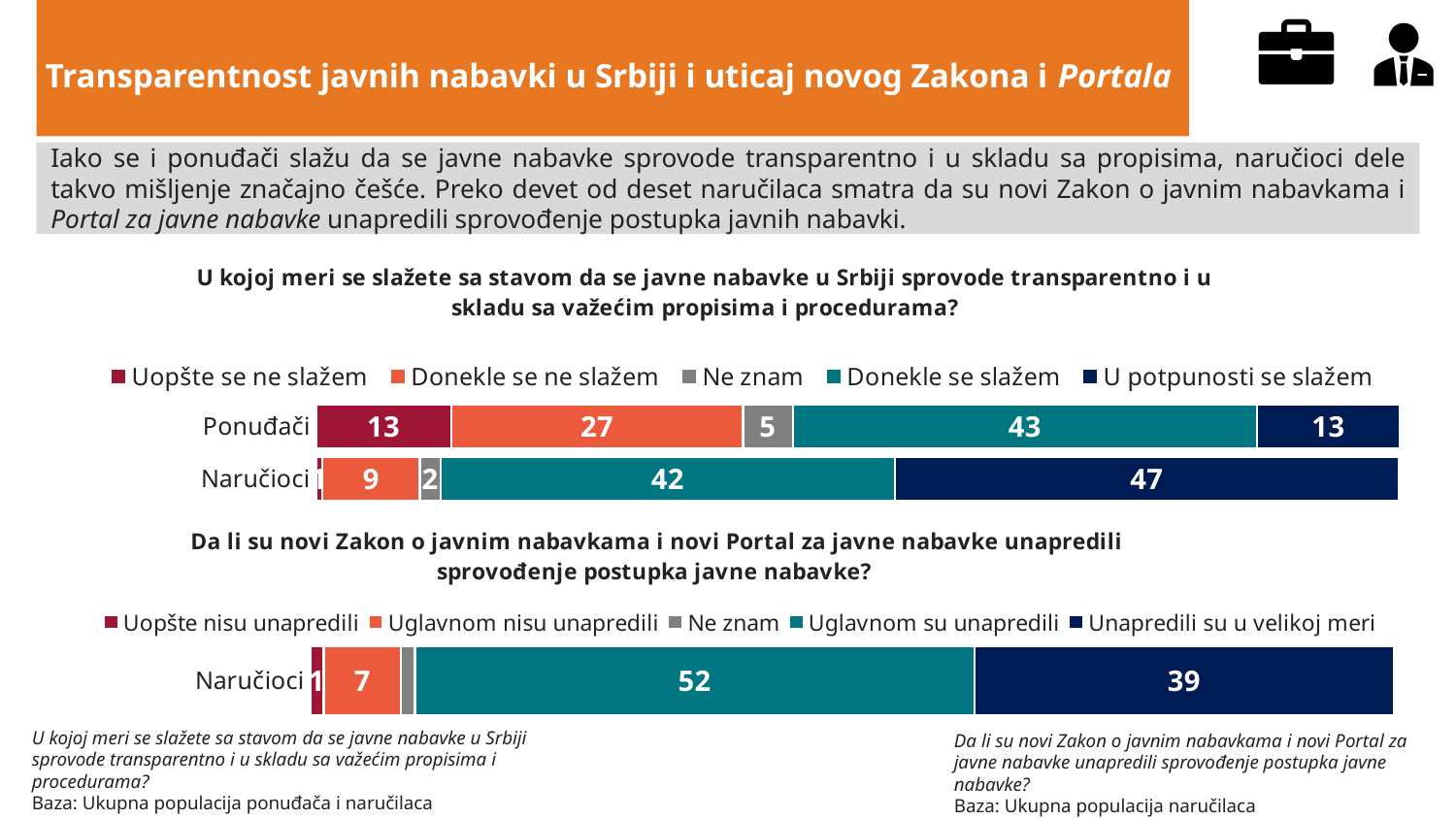
In the top chart, what is the difference between 'U potpunosti se slažem' for Naručioci and for Ponuđači? 34 What type of chart is the bottom chart? Stacked bar chart How many categories (respondent groups) are shown in the top chart? 2 In the top chart, what is the value for 'Donekle se ne slažem' for Ponuđači? 27 In the bottom chart (new Law and Portal), what is the value for 'Uglavnom su unapredili'? 52 In the top chart, what is the value for 'U potpunosti se slažem' for Naručioci? 47 In the top chart, what is the value for 'Ne znam' for Naručioci? 2 How many series does the legend of the top chart list? 5 In the top chart, which is larger: 'Donekle se ne slažem' for Ponuđači or for Naručioci? Ponuđači In the bottom chart, what is the value for 'Uopšte nisu unapredili'? 1 In the top chart, which response category has the highest value for Naručioci? U potpunosti se slažem In the top chart (transparency of public procurement), what is the value for 'Donekle se slažem' for Ponuđači? 43